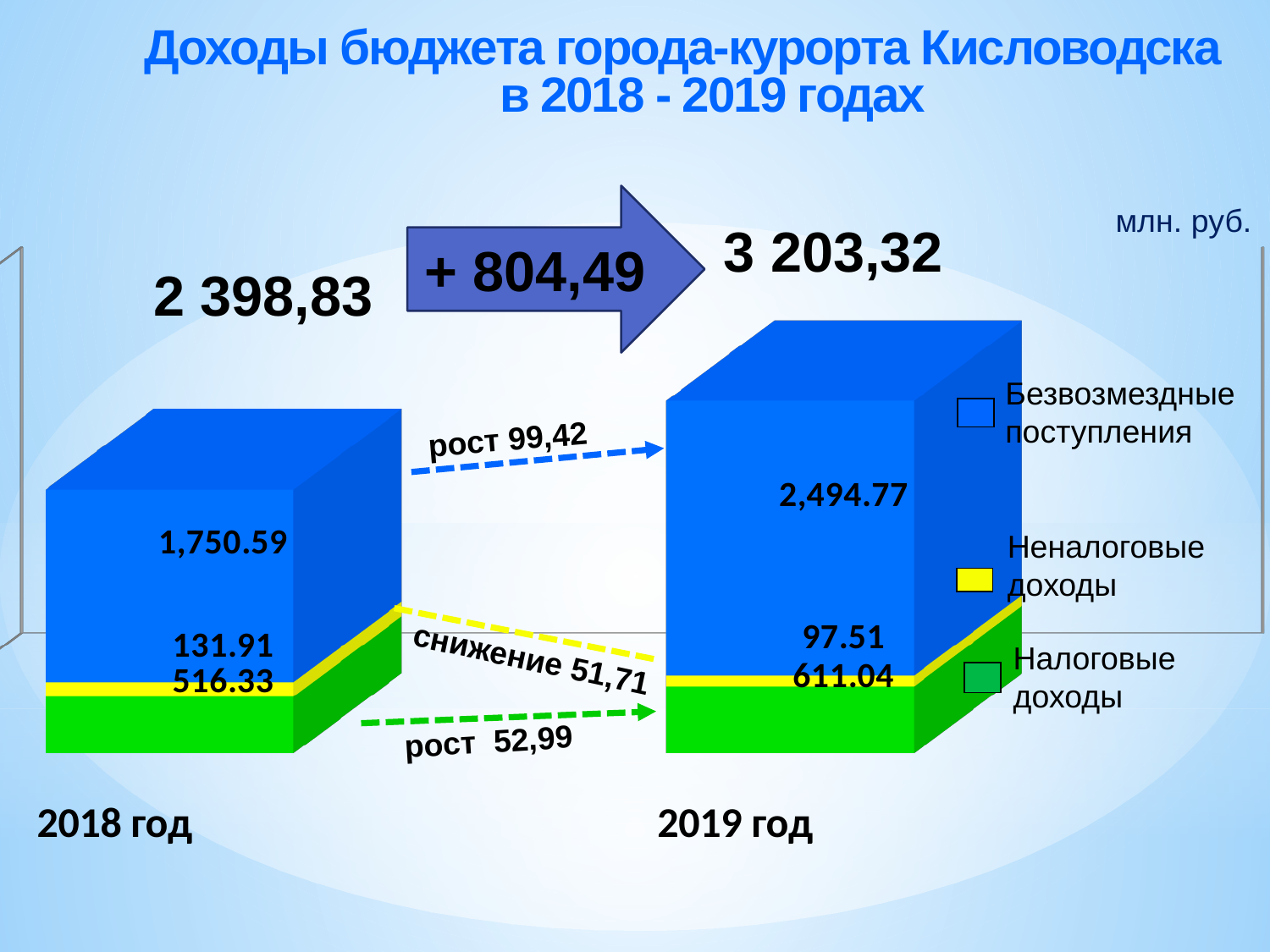
What is the difference between Налоговые доходы in 2019 год and 2018 год? 94.71 How many years (bars) are shown in the chart? 2 Which colour represents Неналоговые доходы in the chart? yellow What is the total of the stacked bar for 2018 год? 2 398,83 What type of chart is shown on the slide? stacked bar chart What is the total of the stacked bar for 2019 год? 3 203,32 What is the value of Налоговые доходы for 2019 год? 611.04 How many series does the legend list? 3 What is the value of Неналоговые доходы for 2019 год? 97.51 Which is larger: Налоговые доходы in 2018 год or in 2019 год? 2019 год What is the value of Безвозмездные поступления for 2018 год? 1,750.59 Which series has the smallest value in 2019 год? Неналоговые доходы